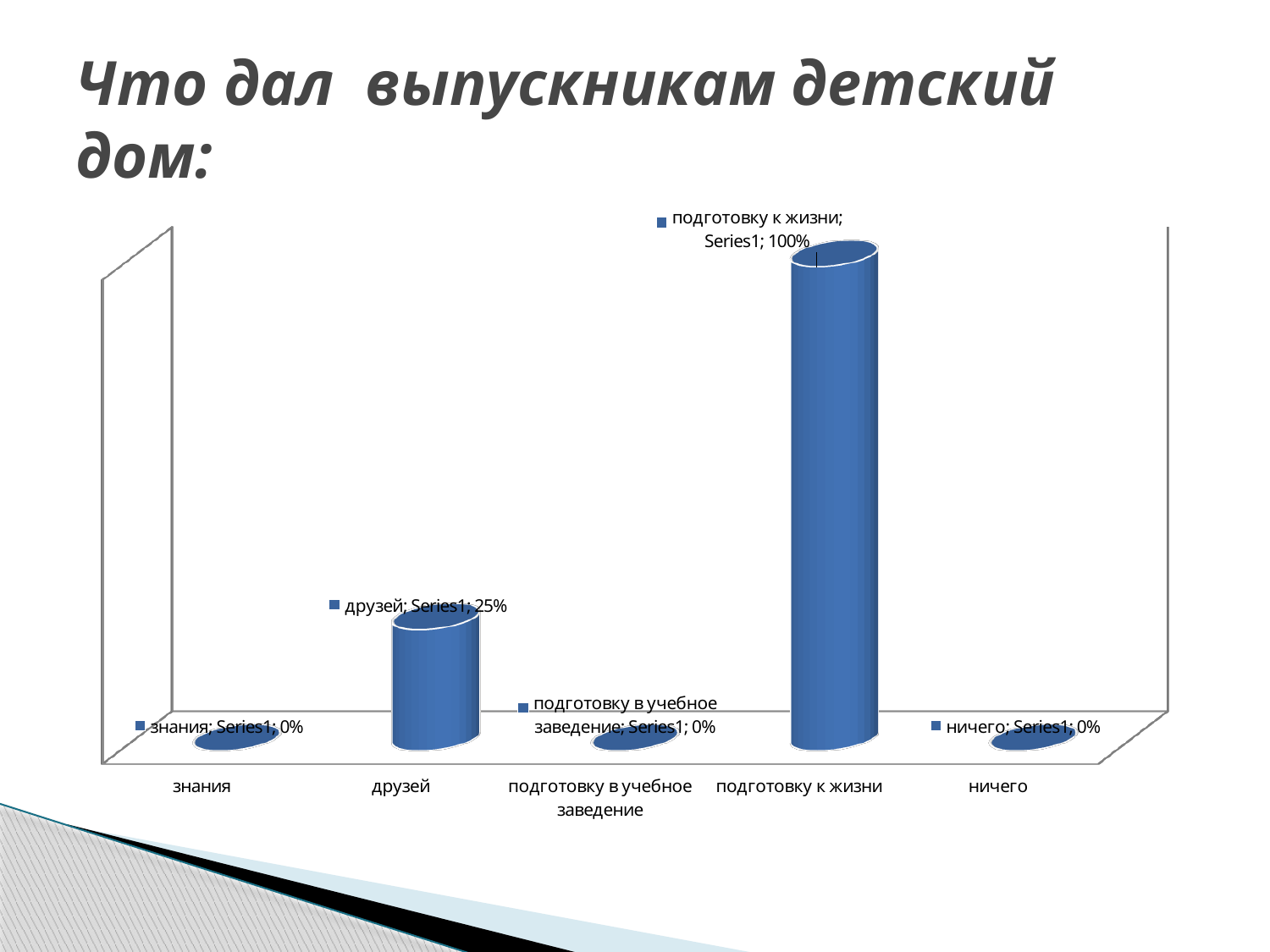
What is the title of the slide? Что дал выпускникам детский дом: Which is larger, the value for друзей or the value for подготовку в учебное заведение? друзей How many categories are shown on the chart? 5 What is the value for знания? 0% What is the value for ничего? 0% What is the value for друзей? 25% What is the difference between the values for подготовку к жизни and друзей? 75% Which category has the highest value? подготовку к жизни How many categories have a value of 0%? 3 What colour are the bars in the chart? blue What is the value for подготовку к жизни? 100% What kind of chart is shown on the slide? bar chart